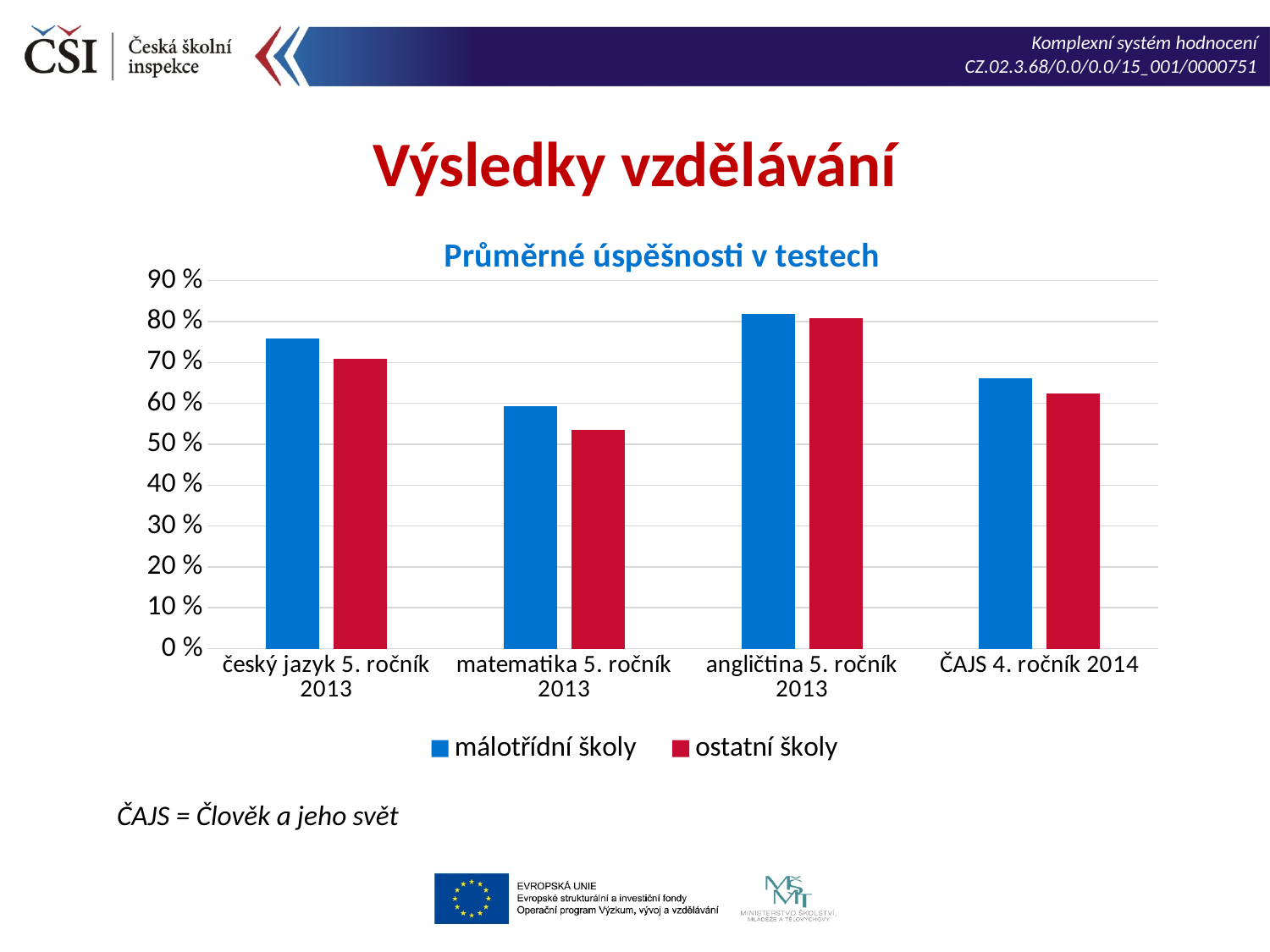
Which series is shown in red? ostatní školy What type of chart is shown on the slide? bar chart What is the title of the chart? Průměrné úspěšnosti v testech In matematika 5. ročník 2013, which is larger: málotřídní školy or ostatní školy? málotřídní školy Is the value for málotřídní školy in český jazyk 5. ročník 2013 greater or less than 70 %? greater Is the value for ostatní školy in ČAJS 4. ročník 2014 greater or less than 70 %? less Which category has the highest value for málotřídní školy? angličtina 5. ročník 2013 In český jazyk 5. ročník 2013, which is larger: málotřídní školy or ostatní školy? málotřídní školy How many series does the legend list? 2 Which category has the lowest value for ostatní školy? matematika 5. ročník 2013 Is the value for ostatní školy in matematika 5. ročník 2013 greater or less than 60 %? less How many categories are shown on the x axis? 4